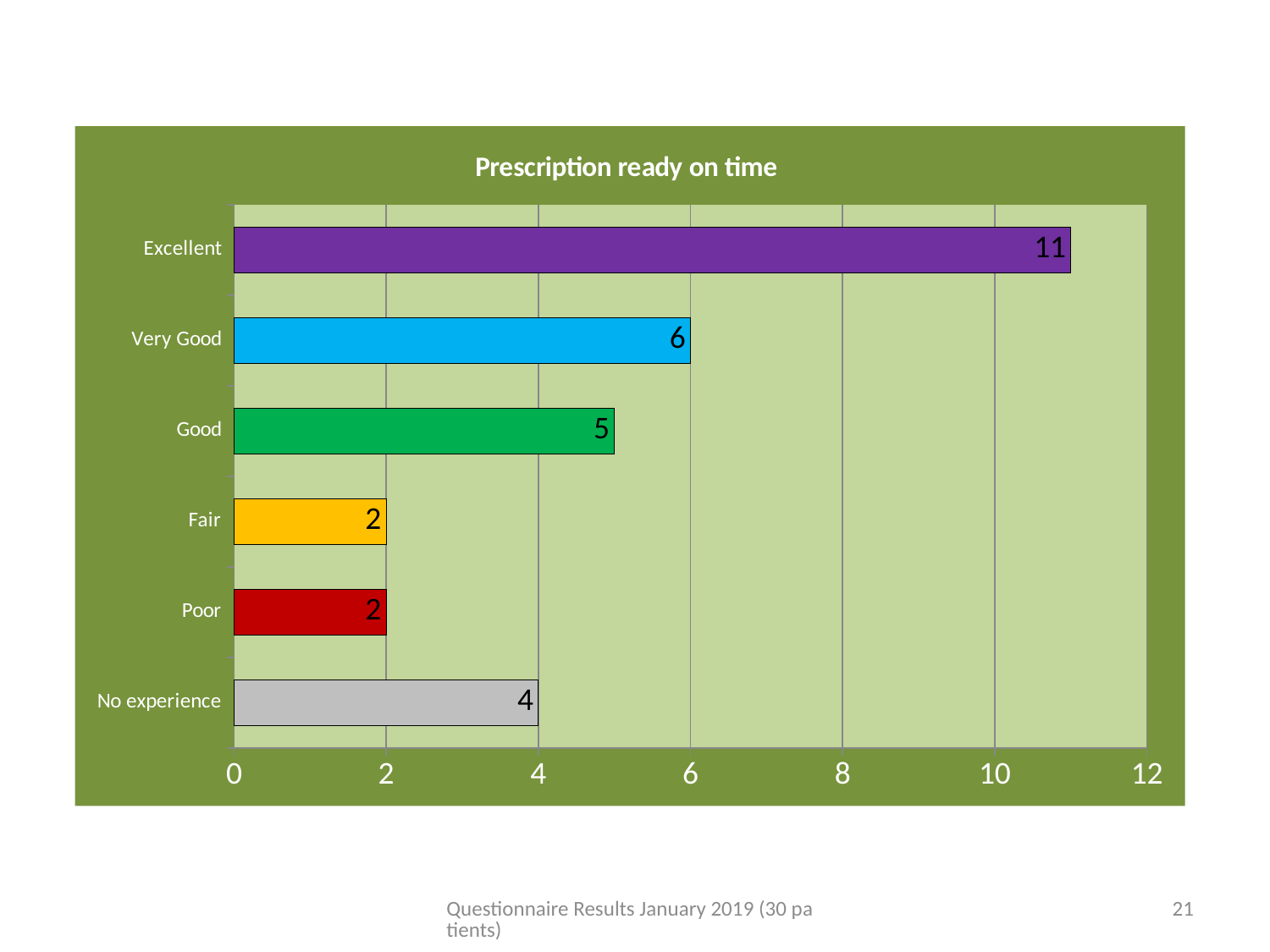
Is the value for Excellent greater or less than 10? greater What is the value for Excellent? 11 What kind of chart is shown? bar chart What is the value for No experience? 4 What is the difference between the values for Excellent and Very Good? 5 What colour is the bar for Poor? red How many categories are shown in the chart? 6 What is the value for Very Good? 6 What is the difference between the values for Good and No experience? 1 Which category has the highest value? Excellent What is the title of the chart? Prescription ready on time Which is larger, the value for Good or the value for No experience? Good